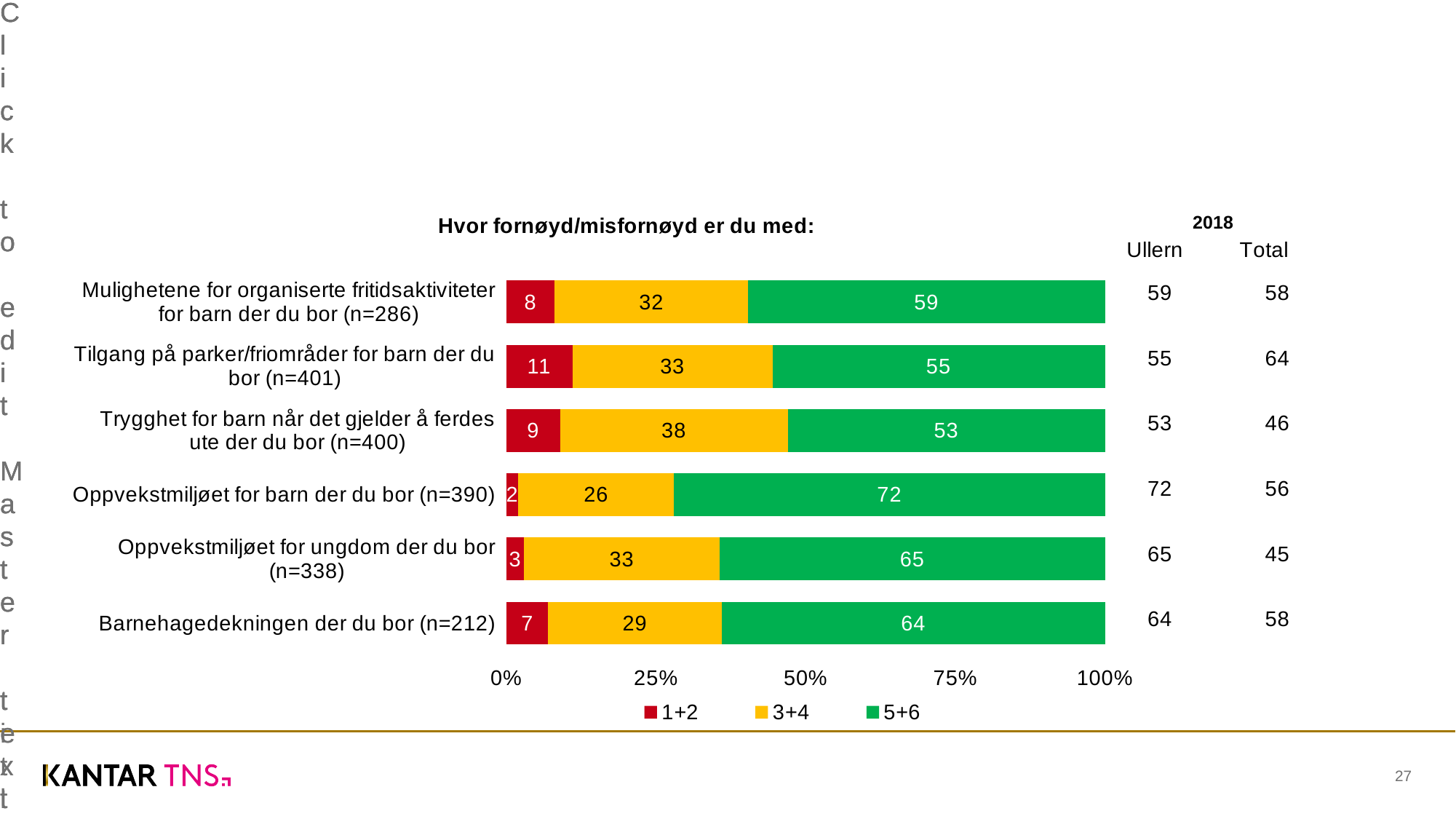
Which category has the highest 5+6 value? Oppvekstmiljøet for barn der du bor (n=390) What is the difference between the 5+6 values for "Barnehagedekningen der du bor (n=212)" and "Trygghet for barn når det gjelder å ferdes ute der du bor (n=400)"? 11 How many categories are plotted in the chart? 6 What is the 1+2 value for "Tilgang på parker/friområder for barn der du bor (n=401)"? 11 What is the total of the stacked bar for "Trygghet for barn når det gjelder å ferdes ute der du bor (n=400)"? 100 Which is larger: the 3+4 value for "Mulighetene for organiserte fritidsaktiviteter for barn der du bor (n=286)" or for "Barnehagedekningen der du bor (n=212)"? Mulighetene for organiserte fritidsaktiviteter for barn der du bor (n=286) What is the 3+4 value for "Trygghet for barn når det gjelder å ferdes ute der du bor (n=400)"? 38 What is the 5+6 value for "Oppvekstmiljøet for barn der du bor (n=390)"? 72 How many series does the legend list? 3 What kind of chart is shown on the slide? Stacked bar chart What is the title of the chart? Hvor fornøyd/misfornøyd er du med: Which category has the lowest 1+2 value? Oppvekstmiljøet for barn der du bor (n=390)